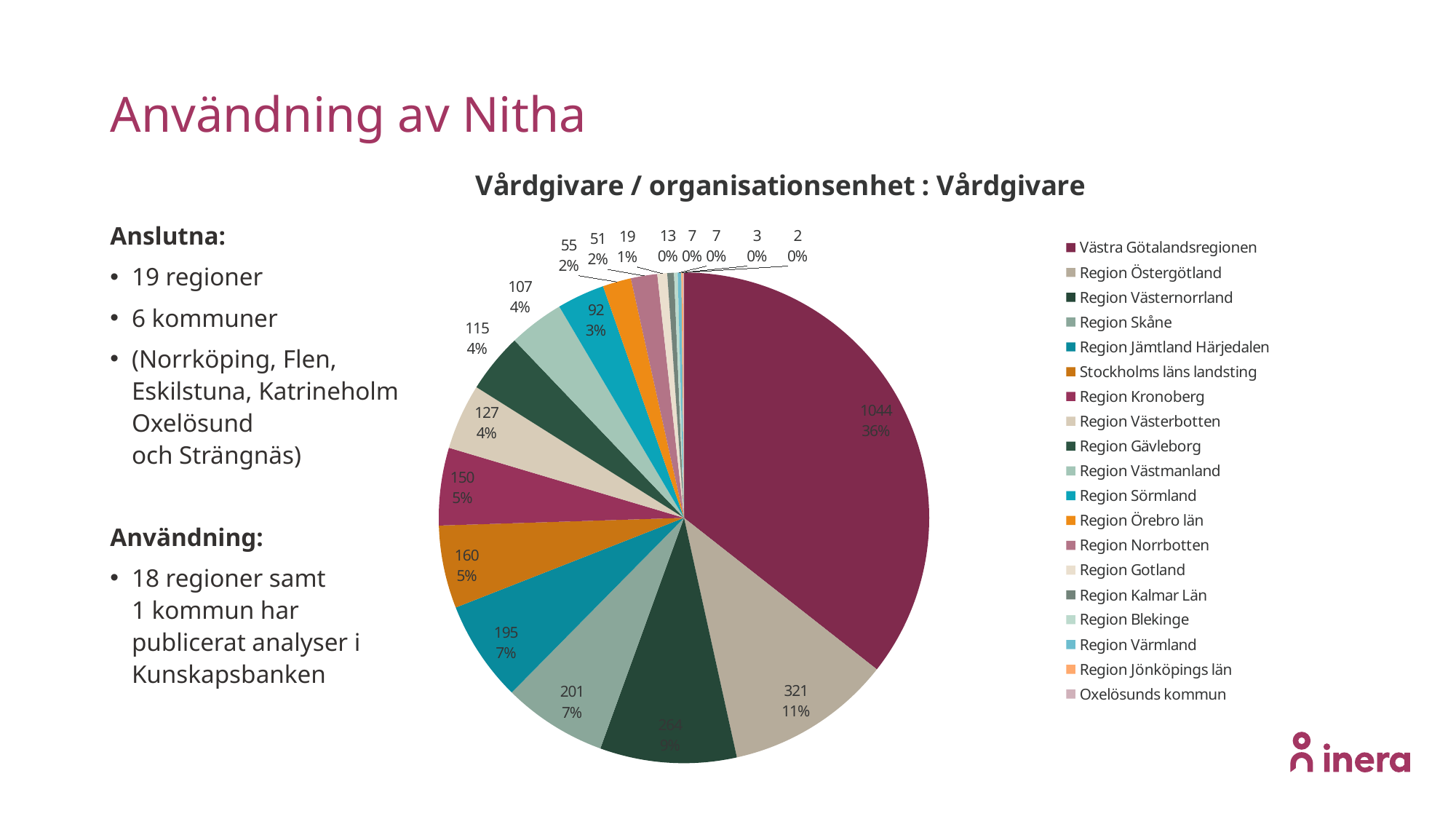
Which is larger, the value for Stockholms läns landsting or the value for Region Kronoberg? Stockholms läns landsting How many entries does the chart legend list? 19 What kind of chart is shown on the slide? pie chart Which legend entry has the smallest slice of the pie? Oxelösunds kommun Which region has the largest slice of the pie? Västra Götalandsregionen What is the difference between the values for Västra Götalandsregionen and Region Östergötland? 723 What value is shown for Region Östergötland? 321 What share of the pie does Västra Götalandsregionen represent? 36% What percentage is shown for Region Västernorrland? 9% What is the title of the chart? Vårdgivare / organisationsenhet : Vårdgivare What value is shown for Region Sörmland? 92 What value is shown for Västra Götalandsregionen? 1044